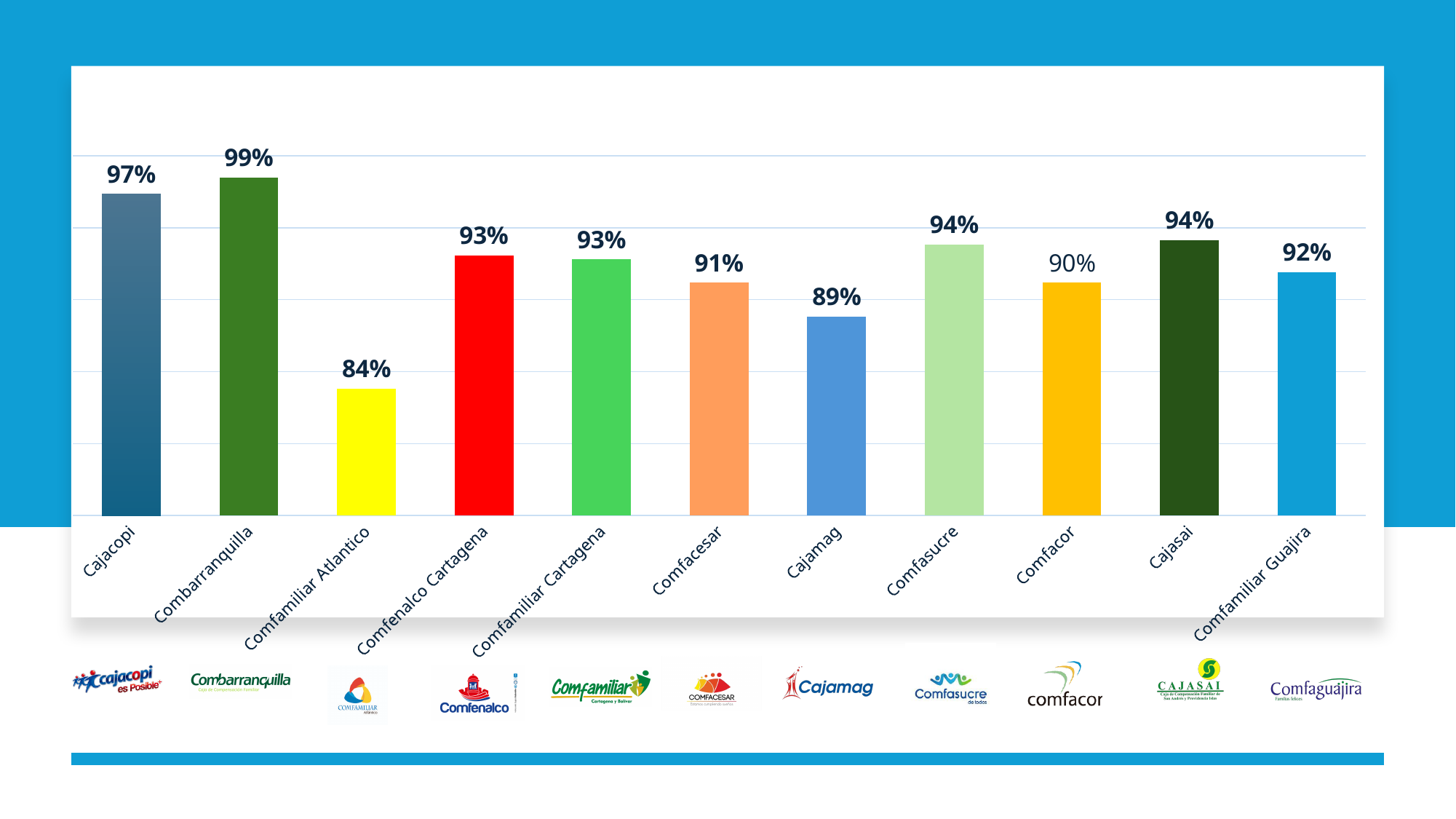
What is the difference between the values for Cajacopi and Comfacesar? 6% What is the difference between the values for Combarranquilla and Comfamiliar Atlantico? 15% What is the value for Comfamiliar Atlantico? 84% What is the value for Combarranquilla? 99% Which category has the lowest value? Comfamiliar Atlantico What kind of chart is shown on the slide? Bar chart What is the value for Cajamag? 89% What is the value for Comfamiliar Guajira? 92% Which category has the highest value? Combarranquilla Which is larger, the value for Cajacopi or the value for Comfacor? Cajacopi How many categories are shown in the chart? 11 What colour is the bar for Comfenalco Cartagena? Red